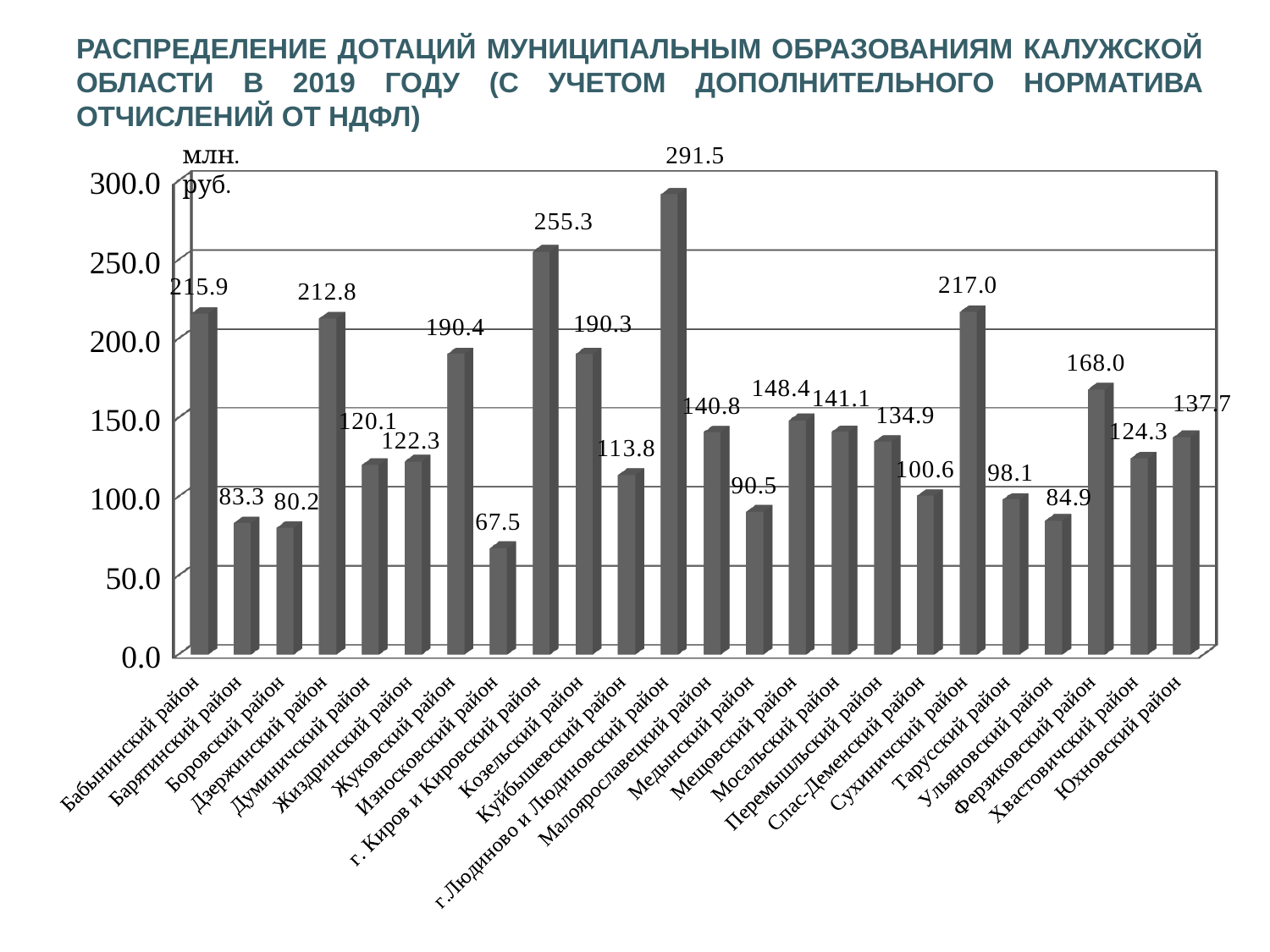
What is the value for Бабынинский район? 215.9 What is the value for г. Киров и Кировский район? 255.3 Which is larger, the value for Ферзиковский район or Хвастовичский район? Ферзиковский район What kind of chart is shown on the slide? bar chart What is the difference between the values for г.Людиново и Людиновский район and Износковский район? 224.0 What is the value for Спас-Деменский район? 100.6 Which district has the lowest value? Износковский район What unit is shown on the vertical axis of the chart? млн. руб. What is the difference between the values for Мещовский район and Мосальский район? 7.3 How many districts are shown on the chart? 24 What is the value for Юхновский район? 137.7 Which district has the highest value? г.Людиново и Людиновский район